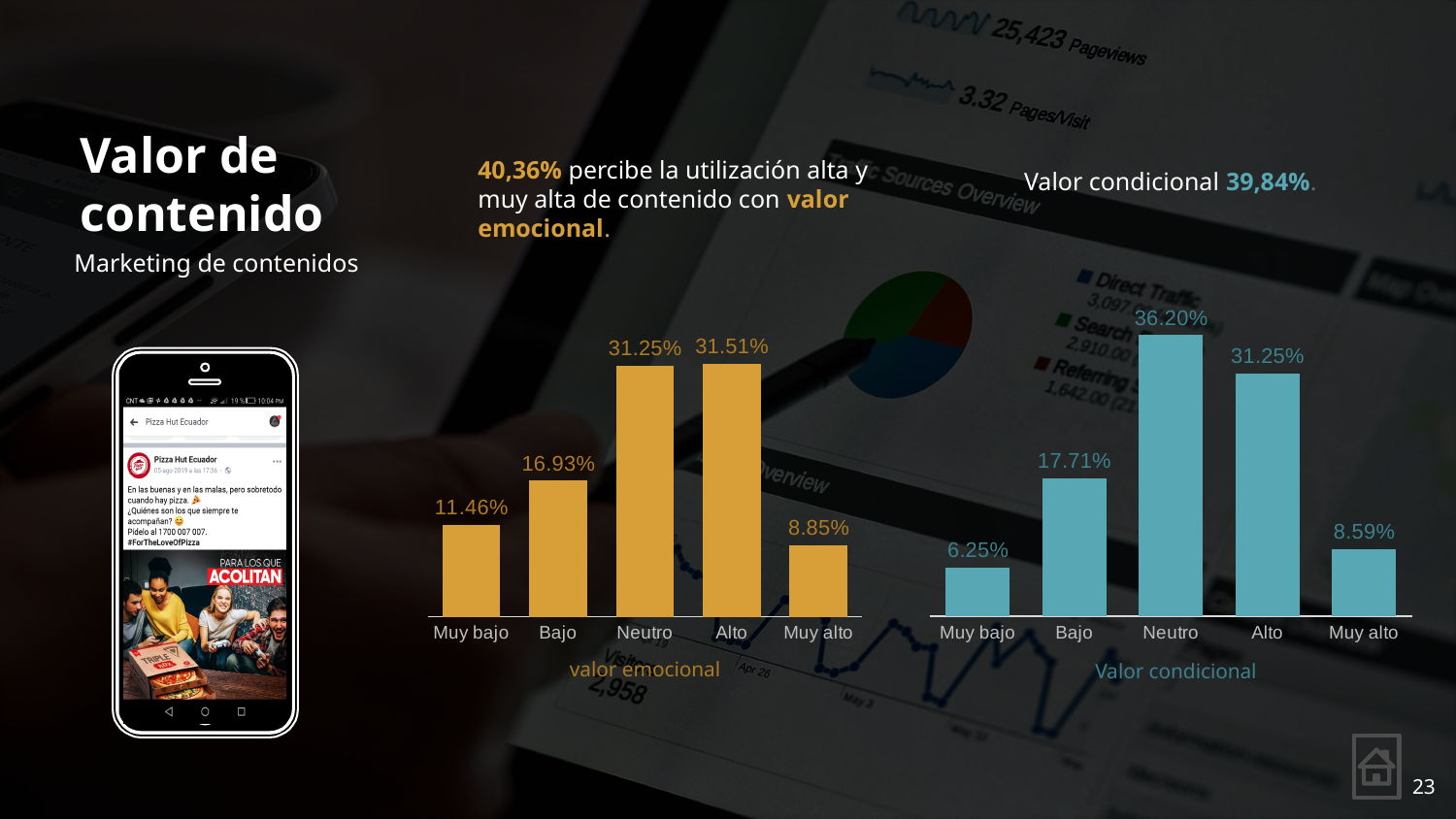
In the 'Valor condicional' chart, which is larger, Bajo or Muy alto? Bajo How many categories does the 'valor emocional' chart show? 5 In the 'valor emocional' chart, what is the value for Bajo? 16.93% In the 'valor emocional' chart, which category has the lowest value? Muy alto In the 'valor emocional' chart, what is the value for Muy alto? 8.85% In the 'Valor condicional' chart, what is the value for Muy bajo? 6.25% In the 'Valor condicional' chart, what is the value for Neutro? 36.20% In the 'Valor condicional' chart, which category has the highest value? Neutro In the 'Valor condicional' chart, which category has the lowest value? Muy bajo In the 'Valor condicional' chart, what is the difference between Neutro and Alto? 4.95% What type of chart is the 'Valor condicional' chart? Bar chart In the 'valor emocional' chart, what is the difference between Bajo and Muy bajo? 5.47%